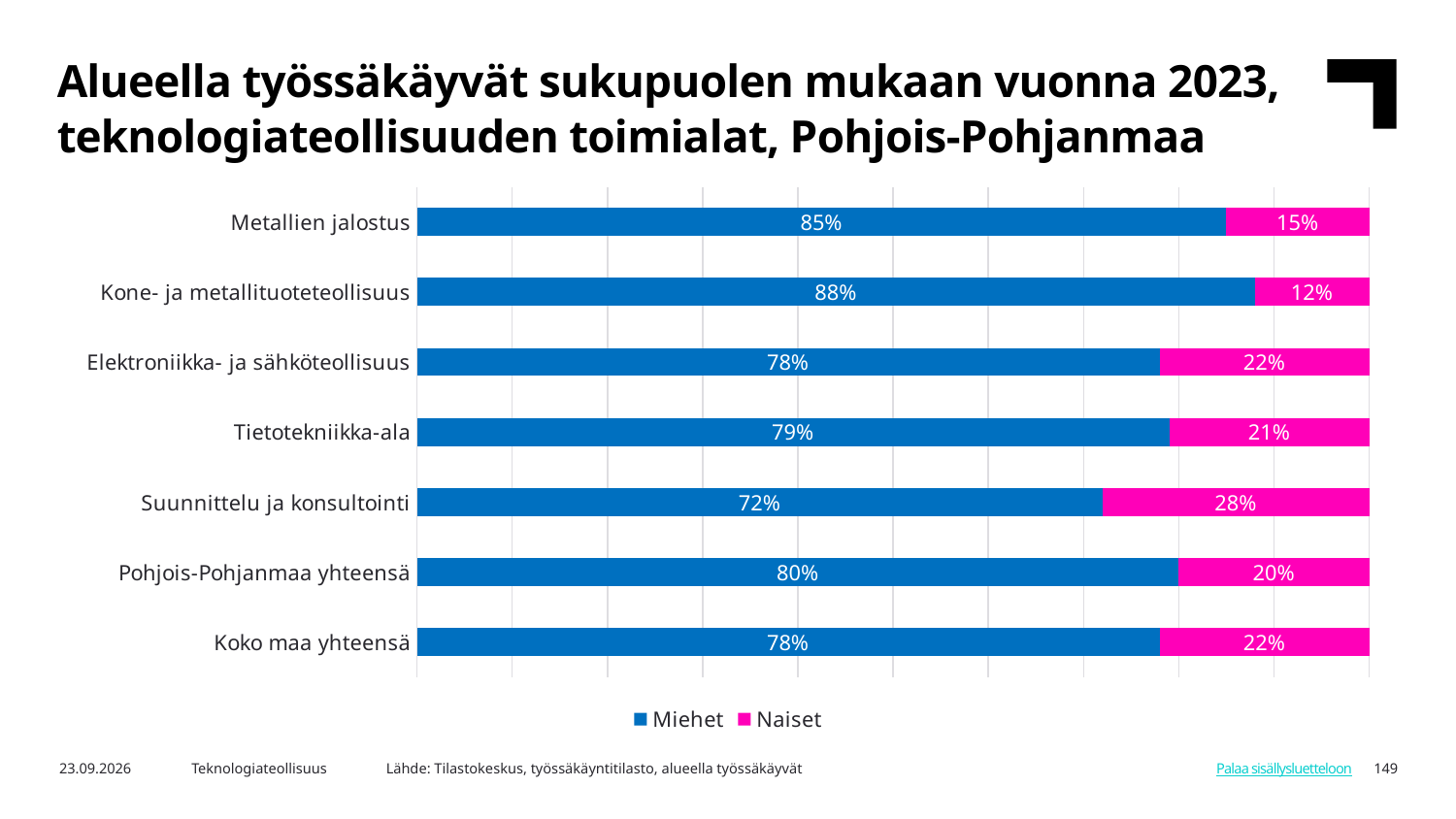
How many series does the legend list? 2 Which category has the lowest Miehet share? Suunnittelu ja konsultointi What is the Miehet share for Pohjois-Pohjanmaa yhteensä? 80% Which has a larger Naiset share, Elektroniikka- ja sähköteollisuus or Tietotekniikka-ala? Elektroniikka- ja sähköteollisuus Which category has the highest Miehet share? Kone- ja metallituoteteollisuus What is the Miehet share for Metallien jalostus? 85% What is the Naiset share for Kone- ja metallituoteteollisuus? 12% What is the Naiset share for Suunnittelu ja konsultointi? 28% How many categories are shown on the chart? 7 What is the total of the stacked bar for Koko maa yhteensä? 100% What kind of chart is shown on the slide? Stacked bar chart What is the difference between the Miehet share for Metallien jalostus and for Tietotekniikka-ala? 6%